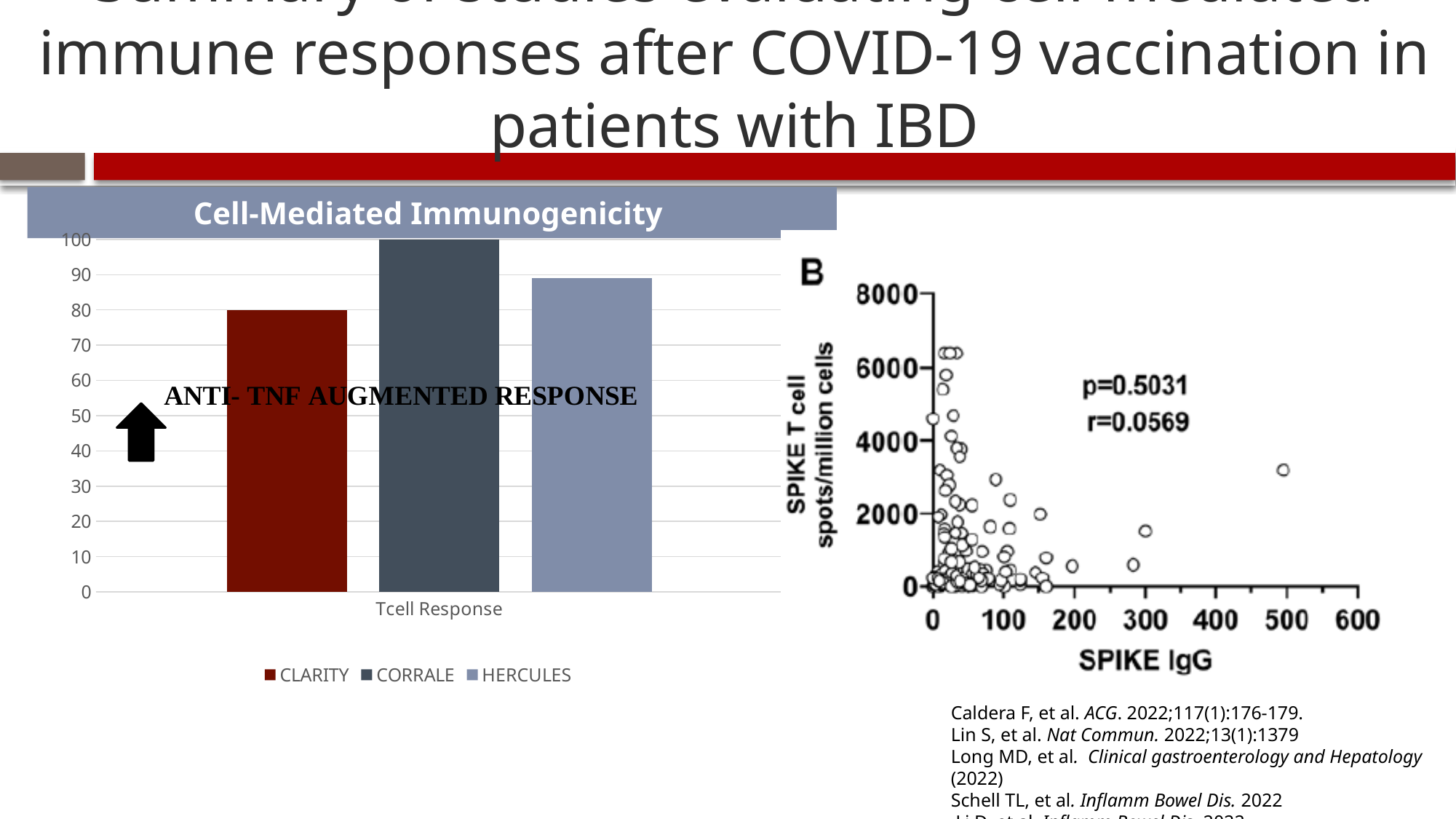
In the 'Cell-Mediated Immunogenicity' chart, which series has the lowest value? CLARITY In the 'Cell-Mediated Immunogenicity' chart, how many series does the legend list? 3 In the 'Cell-Mediated Immunogenicity' chart, which series has the highest value? CORRALE In the 'Cell-Mediated Immunogenicity' chart, what is the value for CORRALE? 100 What kind of chart is the 'Cell-Mediated Immunogenicity' chart on the left of the slide? bar chart In the 'Cell-Mediated Immunogenicity' chart, what is the value for CLARITY? 80 In the 'Cell-Mediated Immunogenicity' chart, is the value for HERCULES greater or less than 80? greater In the 'Cell-Mediated Immunogenicity' chart, which is larger, HERCULES or CLARITY? HERCULES What kind of chart is the chart on the right of the slide, labelled B? scatter plot In the 'Cell-Mediated Immunogenicity' chart, what is the difference between the CORRALE and CLARITY values? 20 In the scatter plot on the right of the slide, what p value is printed? p=0.5031